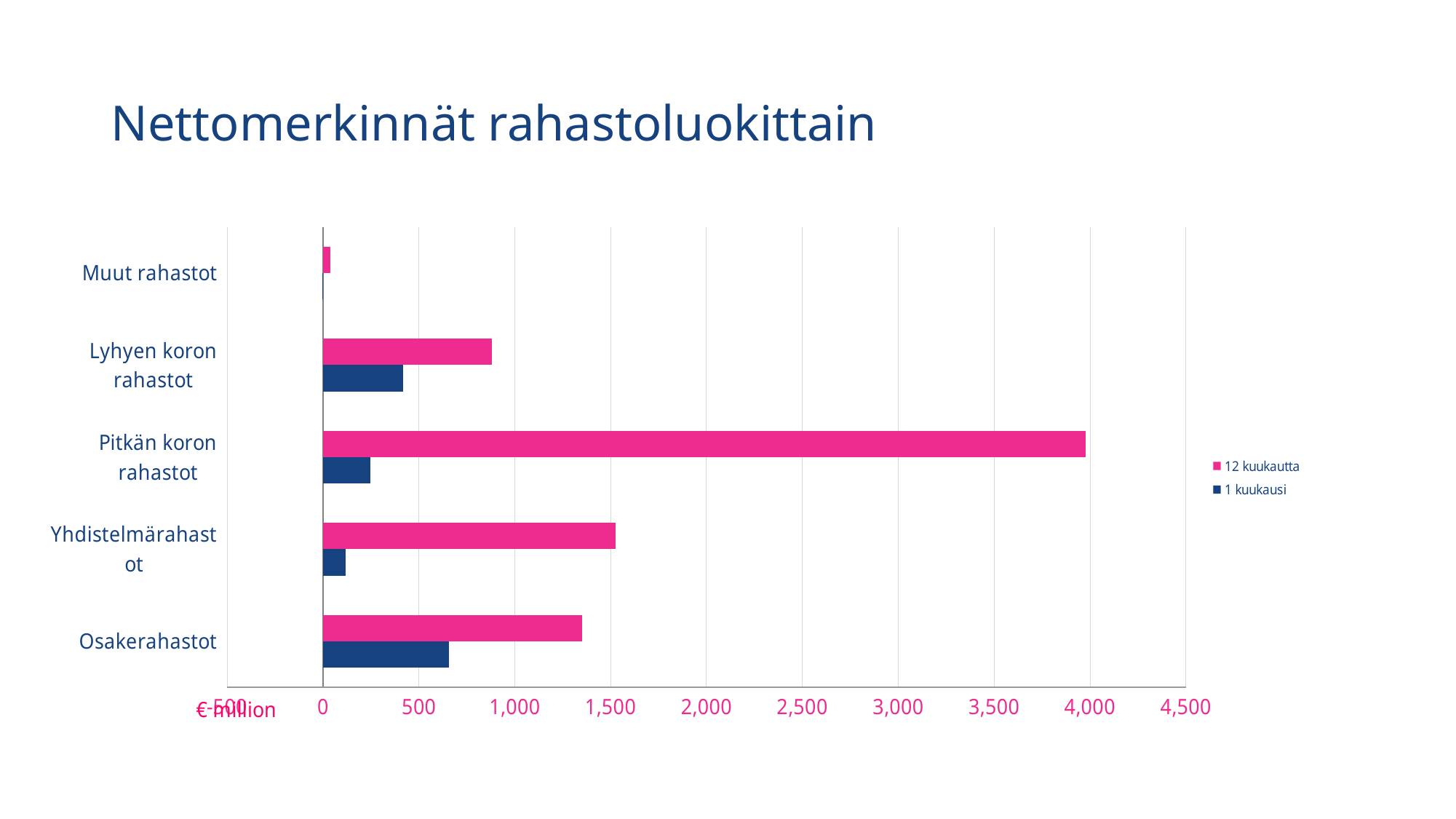
How many fund categories are shown on the chart? 5 How many series does the legend list? 2 What is the title of the chart? Nettomerkinnät rahastoluokittain Which category has the highest value for the 12 kuukautta series? Pitkän koron rahastot Is the 1 kuukausi value for Osakerahastot greater or less than 500? greater Is the 12 kuukautta value for Pitkän koron rahastot greater or less than 3,500? greater What kind of chart is shown on the slide? bar chart Which category has the larger 12 kuukautta value: Yhdistelmärahastot or Osakerahastot? Yhdistelmärahastot Which is larger for Osakerahastot: the 12 kuukautta value or the 1 kuukausi value? 12 kuukautta Which category has the highest value for the 1 kuukausi series? Osakerahastot Is the 12 kuukautta value for Lyhyen koron rahastot greater or less than 1,000? less Which category has the lowest value for the 12 kuukautta series? Muut rahastot